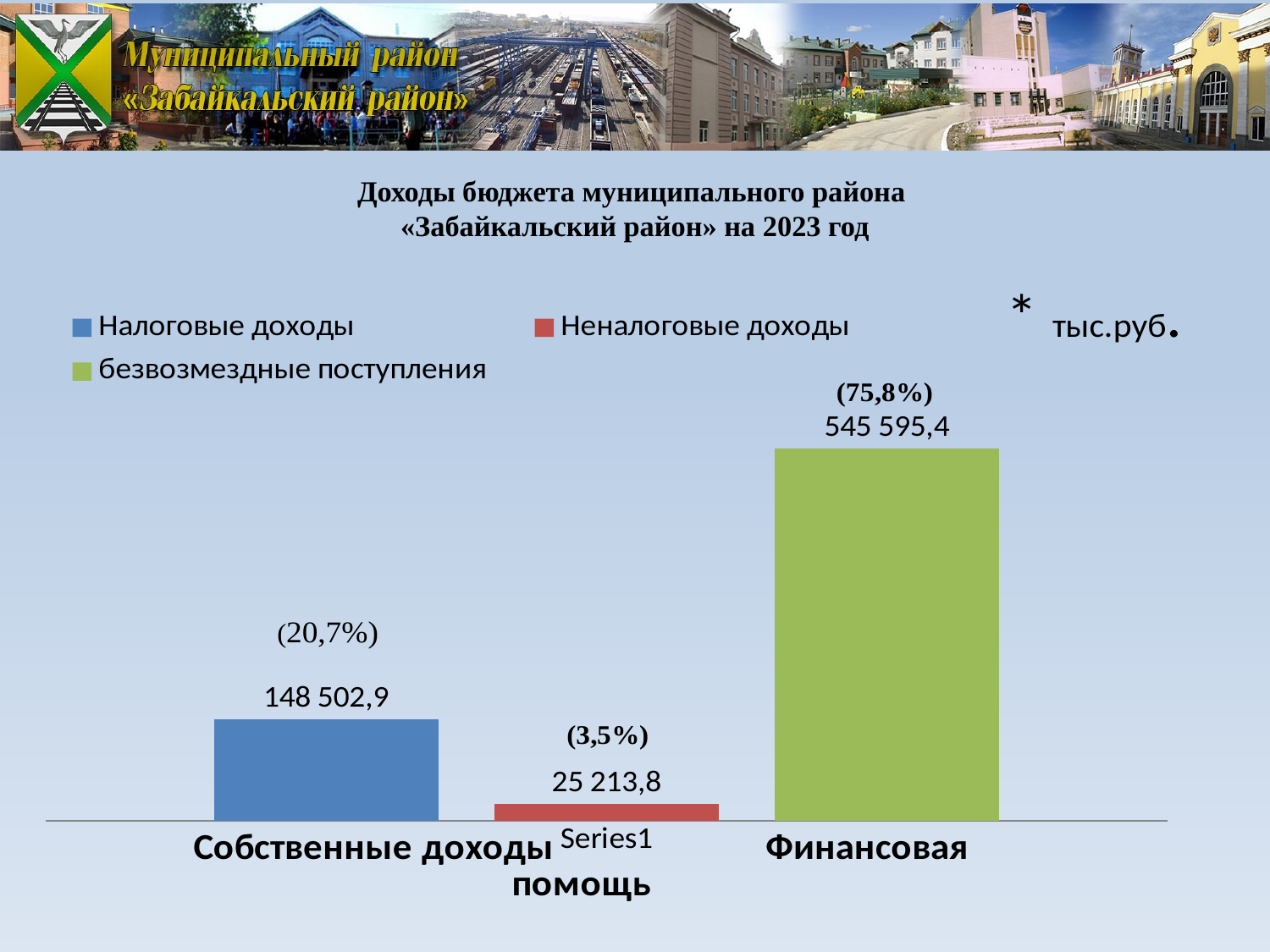
What percentage share is shown for Налоговые доходы? 20,7% Which series has the lowest value? Неналоговые доходы What percentage share is shown for безвозмездные поступления? 75,8% What is the value for Неналоговые доходы? 25 213,8 How many series does the legend list? 3 What unit of measurement is indicated for the chart values? тыс.руб. What kind of chart is shown on the slide? bar chart Which series has the highest value? безвозмездные поступления Which is larger, Налоговые доходы or Неналоговые доходы? Налоговые доходы What is the value for безвозмездные поступления? 545 595,4 What is the difference between безвозмездные поступления and Налоговые доходы? 397 092,5 What is the value for Налоговые доходы? 148 502,9